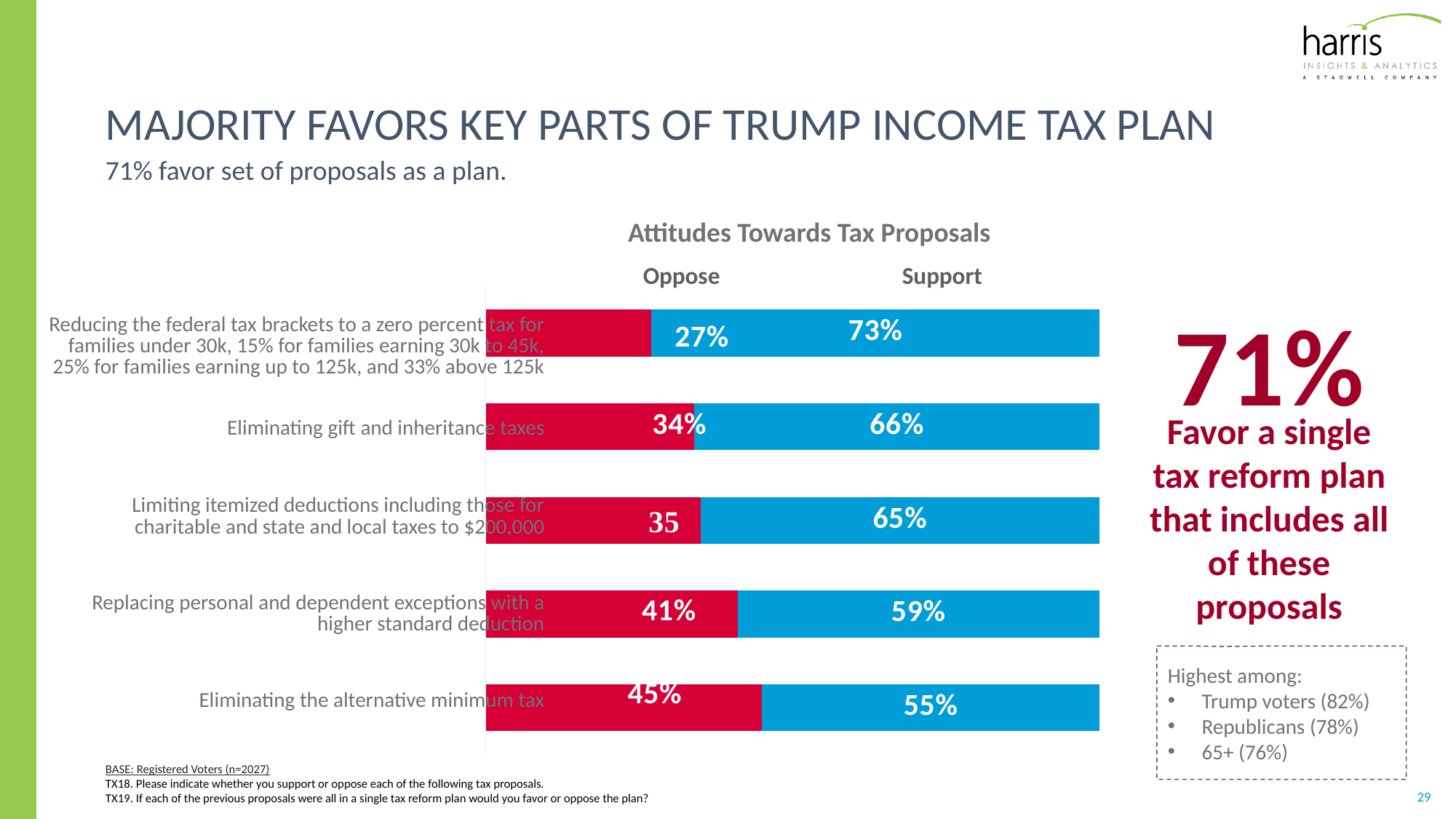
What kind of chart is shown on the slide? Stacked bar chart Which proposal has the lowest Support value? Eliminating the alternative minimum tax What is the title of the chart? Attitudes Towards Tax Proposals What is the Oppose value for replacing personal and dependent exceptions with a higher standard deduction? 41% What is the difference between the Support and Oppose values for eliminating the alternative minimum tax? 10 percentage points What percentage oppose eliminating gift and inheritance taxes? 34% How many series does the chart show? 2 What percentage support reducing the federal tax brackets to a zero percent tax for families under 30k, 15% for families earning 30k to 45k, 25% for families earning up to 125k, and 33% above 125k? 73% Which proposal has the highest Support value? Reducing the federal tax brackets to a zero percent tax for families under 30k, 15% for families earning 30k to 45k, 25% for families earning up to 125k, and 33% above 125k How many tax proposals are shown in the chart? 5 What is the Support value for eliminating the alternative minimum tax? 55% Which is larger: the Oppose value for eliminating gift and inheritance taxes or the Oppose value for eliminating the alternative minimum tax? Eliminating the alternative minimum tax